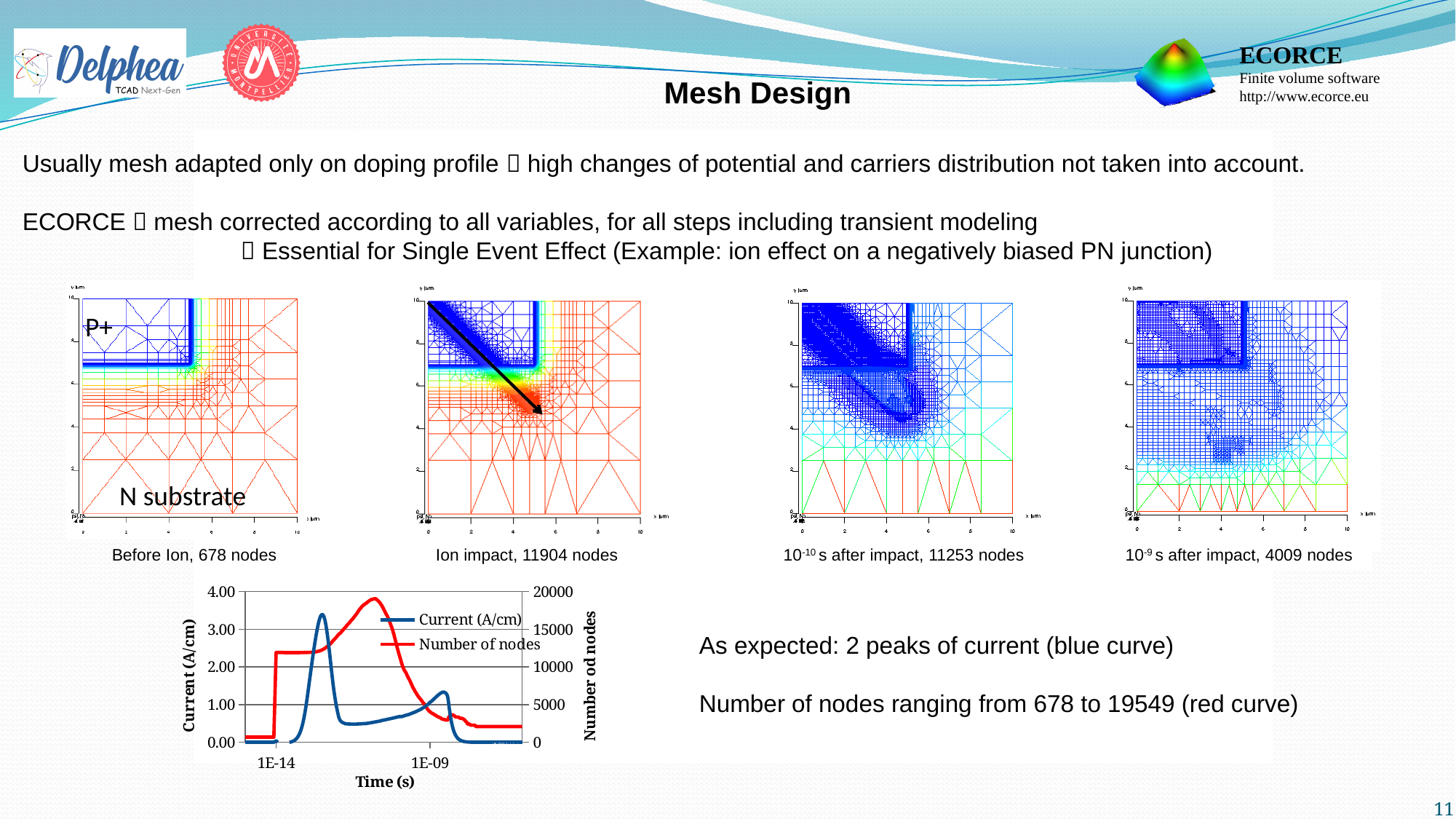
What kind of chart is shown at the bottom left of the slide? line chart In the bottom-left chart, after reaching its maximum, does the Number of nodes curve rise or fall as time increases? fall In the bottom-left chart, is the second peak of the Current (A/cm) curve greater or less than 2.00? less In the bottom-left chart, is the highest value of the Number of nodes curve greater or less than 15000? greater What is the maximum value shown on the left y axis of the bottom-left chart? 4.00 What is the maximum value shown on the right y axis of the bottom-left chart? 20000 How many peaks does the Current (A/cm) curve show in the bottom-left chart? 2 In the bottom-left chart, which series is drawn in red? Number of nodes In the bottom-left chart, is the highest value of the Current (A/cm) curve greater or less than 3.00? greater How many series does the legend of the bottom-left chart list? 2 What are the two series named in the legend of the bottom-left chart? Current (A/cm) and Number of nodes In the bottom-left chart, which peak of the Current (A/cm) curve is higher, the first or the second? the first